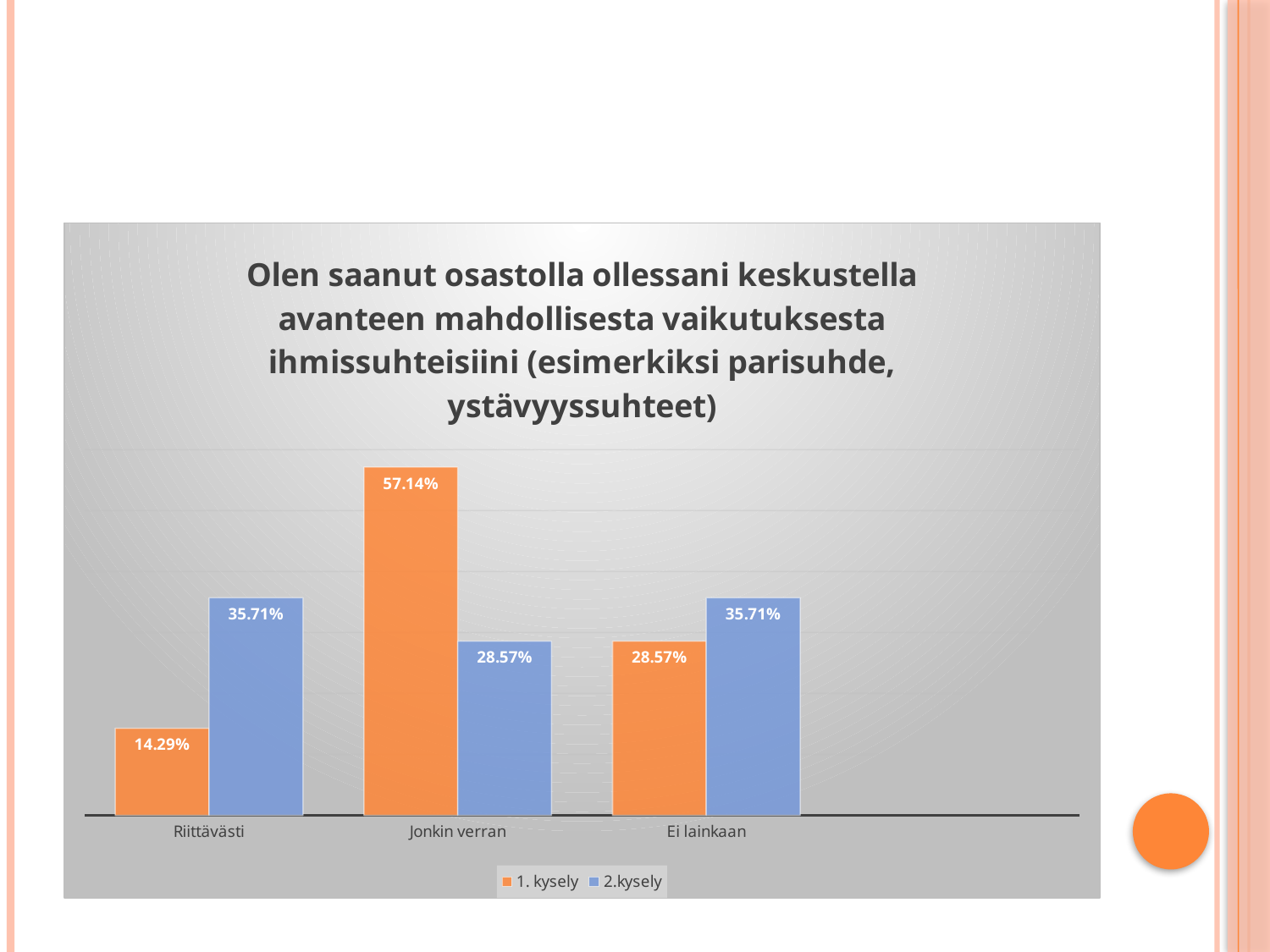
What is the difference between the 2.kysely and 1. kysely values for Riittävästi? 21.42% What is the value for Riittävästi in the 1. kysely series? 14.29% What kind of chart is shown on the slide? Bar chart Which is larger for Ei lainkaan: 1. kysely or 2.kysely? 2.kysely What is the difference between the 1. kysely and 2.kysely values for Jonkin verran? 28.57% What is the value for Jonkin verran in the 2.kysely series? 28.57% Which category has the highest value in the 1. kysely series? Jonkin verran How many categories are shown on the x axis? 3 Which category has the lowest value in the 1. kysely series? Riittävästi How many series does the legend list? 2 Which category has the lowest value in the 2.kysely series? Jonkin verran What is the value for Ei lainkaan in the 1. kysely series? 28.57%